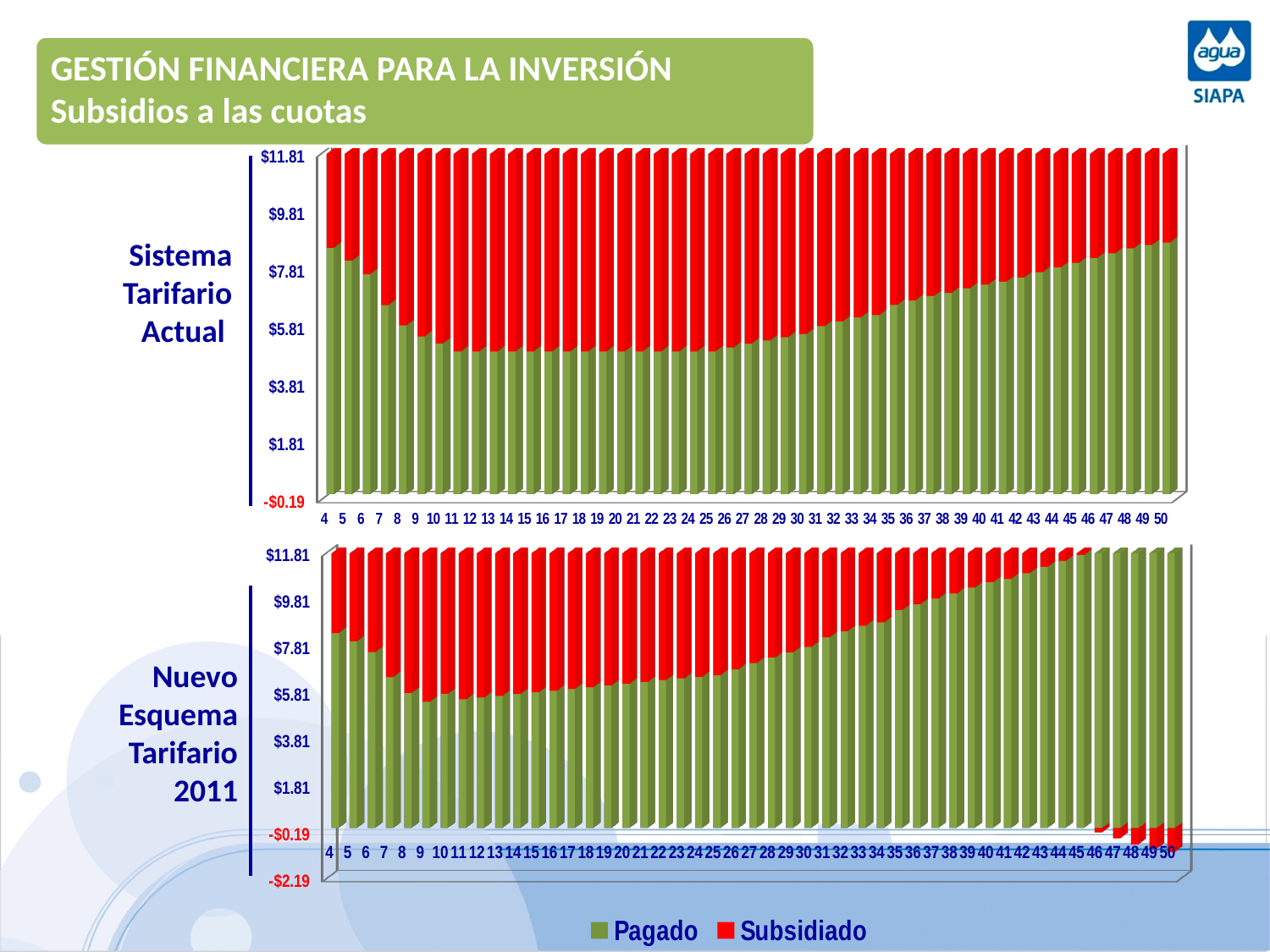
What kind of chart is the 'Sistema Tarifario Actual' chart? stacked bar chart In the 'Nuevo Esquema Tarifario 2011' chart, is the Pagado value for category 40 greater or less than $9.81? greater In the 'Sistema Tarifario Actual' chart, how many categories are shown on the x axis? 47 How many series does the legend list? 2 In the 'Sistema Tarifario Actual' chart, which has the larger Pagado value, category 4 or category 20? category 4 In the 'Nuevo Esquema Tarifario 2011' chart, does the Pagado value rise or fall from category 12 to category 45? rise What are the two series named in the legend? Pagado and Subsidiado In the 'Sistema Tarifario Actual' chart, is the Pagado value for category 4 greater or less than $7.81? greater Which chart shows negative Subsidiado values for categories 47 to 50? Nuevo Esquema Tarifario 2011 In the 'Sistema Tarifario Actual' chart, is the Pagado value for category 25 greater or less than $5.81? less In the 'Nuevo Esquema Tarifario 2011' chart, which has the larger Pagado value, category 10 or category 45? category 45